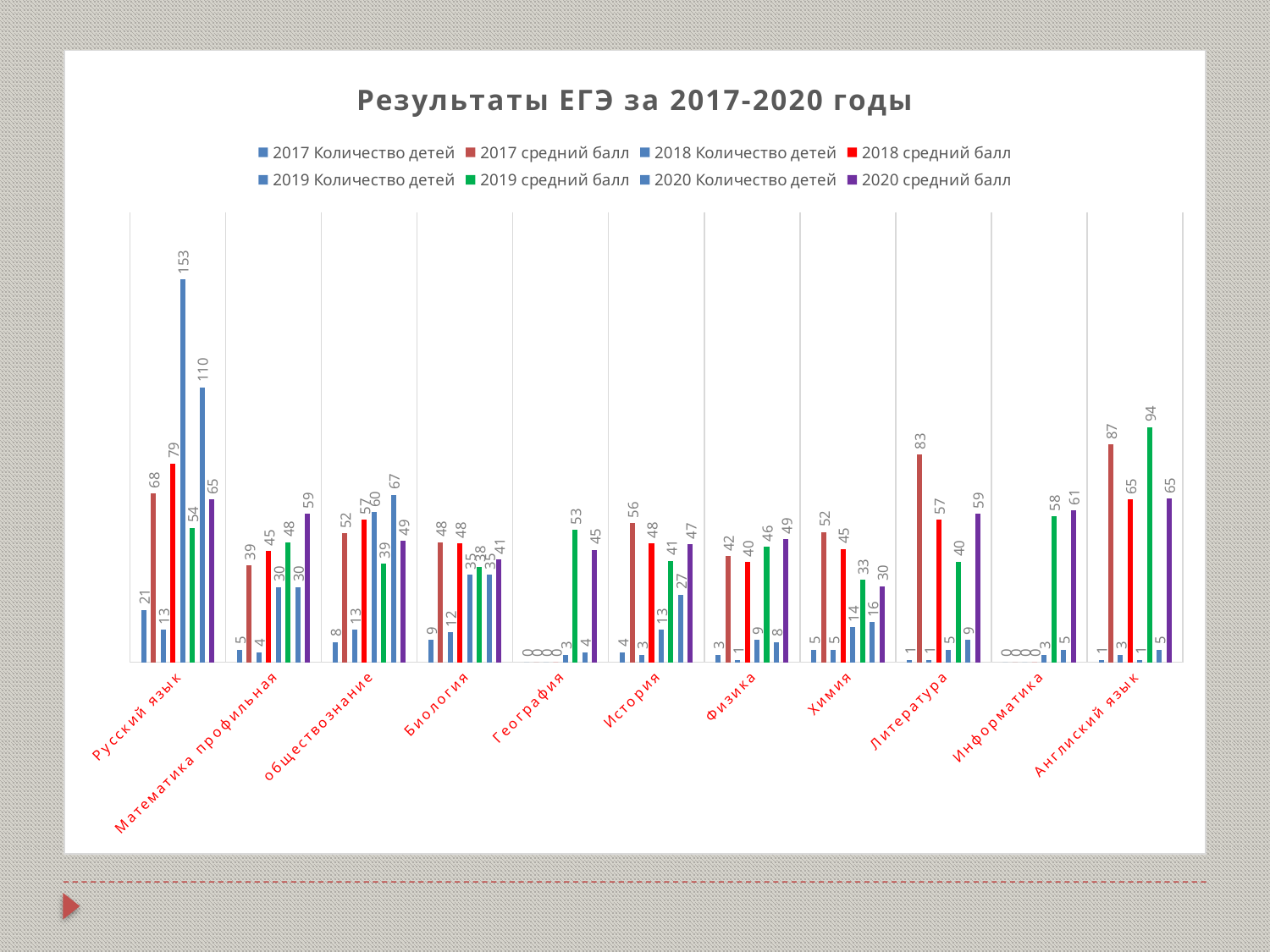
Which subject has the highest 2019 Количество детей value? Русский язык What kind of chart is shown on the slide? Bar chart What is the 2019 средний балл value for Английский язык? 94 How many subject categories are shown on the x axis? 11 Which is larger for Математика профильная: the 2020 средний балл or the 2017 средний балл? 2020 средний балл What is the 2017 средний балл value for Литература? 83 How many series does the legend list? 8 What is the difference between the 2019 Количество детей and 2020 Количество детей values for Русский язык? 43 What is the 2019 Количество детей value for Русский язык? 153 What is the 2020 средний балл value for Химия? 30 What is the 2018 средний балл value for Русский язык? 79 What is the title of the chart? Результаты ЕГЭ за 2017-2020 годы